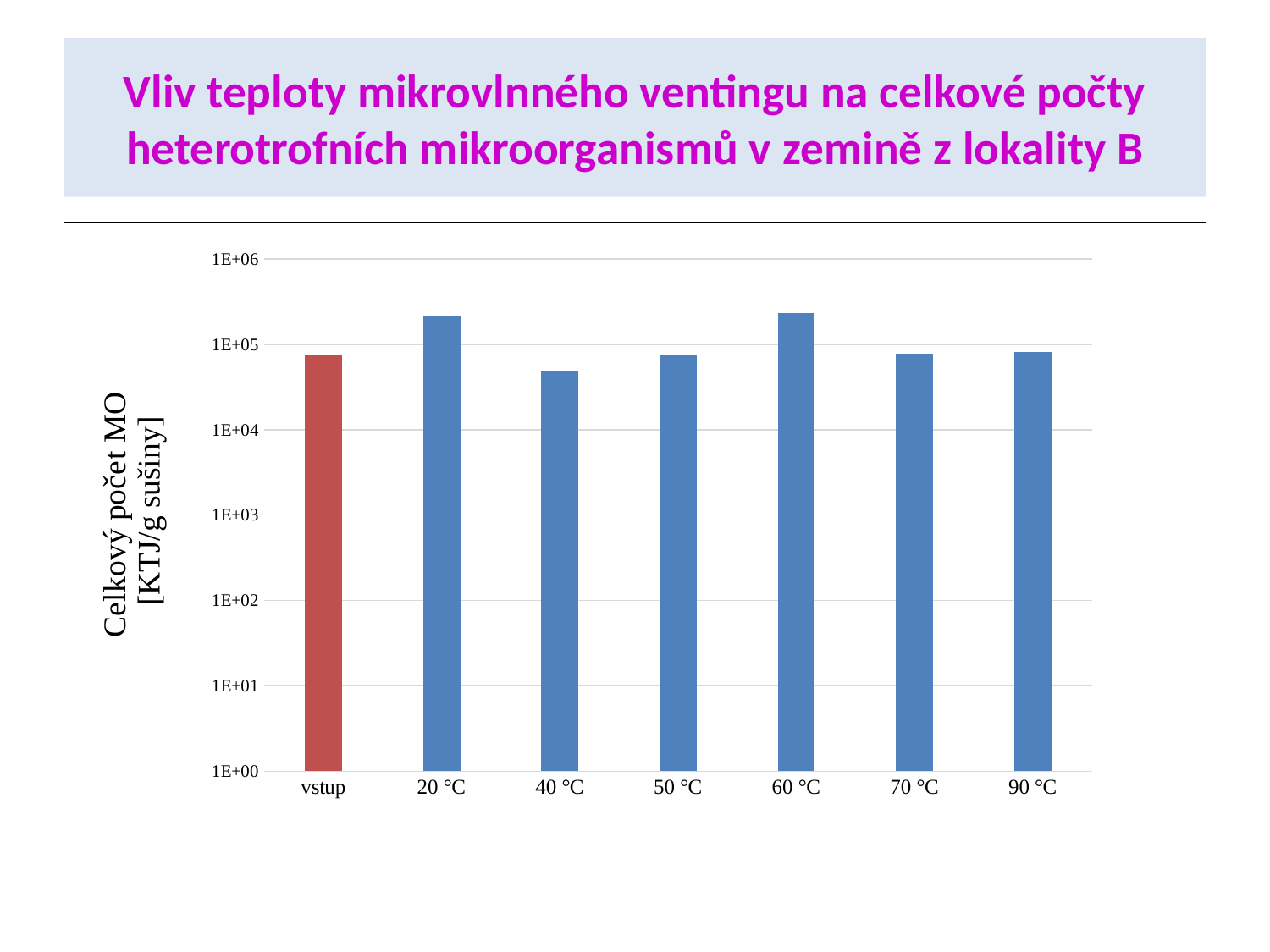
Which category has the lowest value in the chart? 40 °C Is the value for 20 °C greater or less than 1E+05? greater How many categories are shown on the x axis of the chart? 7 What kind of chart is shown on the slide? bar chart What is the label of the y axis of the chart? Celkový počet MO [KTJ/g sušiny] Which category's bar is coloured red rather than blue? vstup Which is larger, the value for 60 °C or the value for 50 °C? 60 °C Which is larger, the value for 20 °C or the value for 40 °C? 20 °C Is the value for 40 °C greater or less than 1E+05? less Is the value for 60 °C greater or less than 1E+05? greater